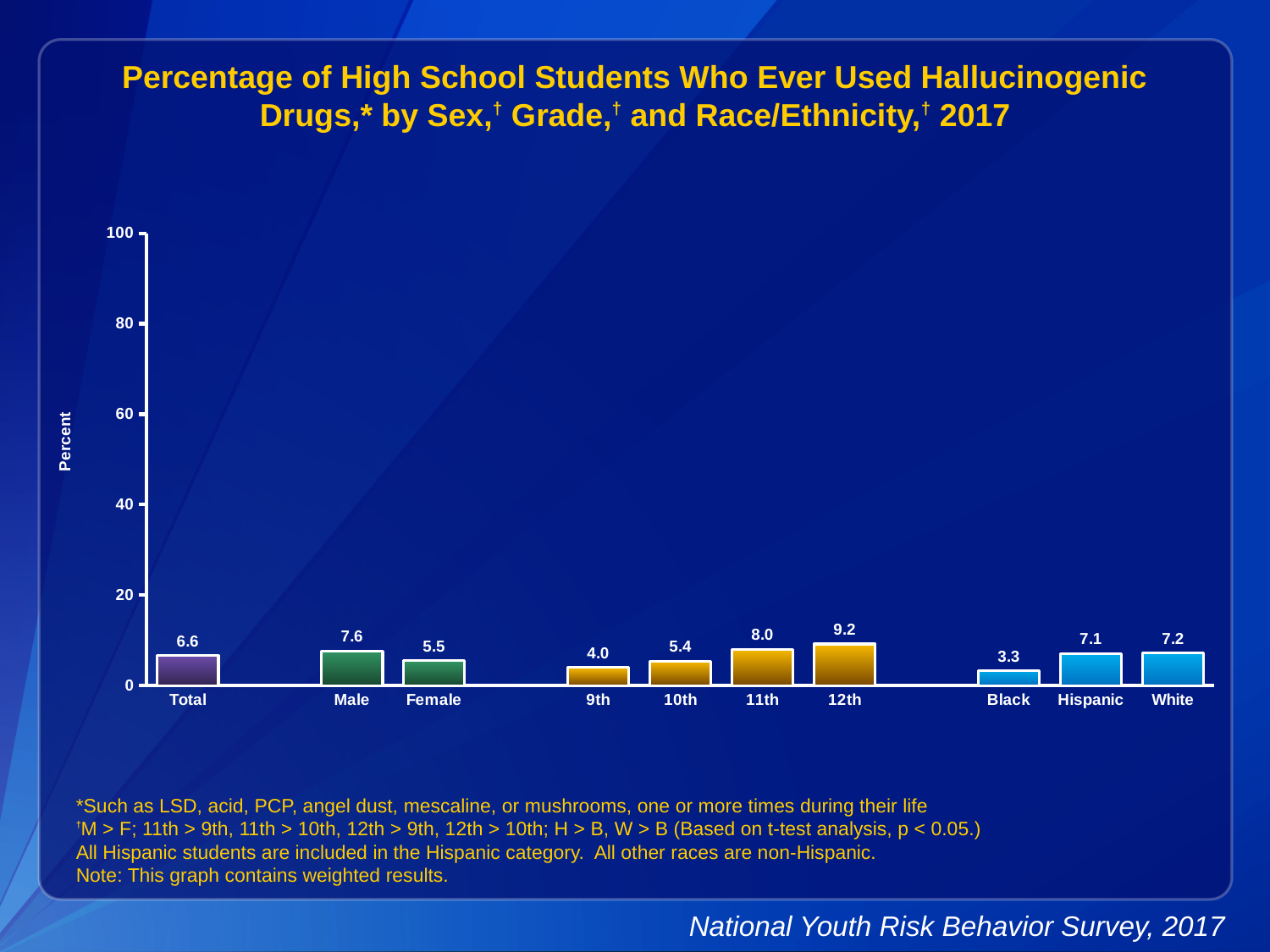
What is the value for 12th grade? 9.2 Which category has the lowest value? Black Which is larger, the value for Hispanic or the value for Black? Hispanic What is the value for Black students? 3.3 What kind of chart is this? bar chart Which category has the highest value? 12th Do the values rise or fall from 9th grade to 12th grade? rise What is the value for Total? 6.6 What is the difference between the values for 12th and 9th grade? 5.2 What is the difference between the values for Male and Female? 2.1 Is the value for 11th grade greater or less than 20? less How many categories are shown on the x axis? 10